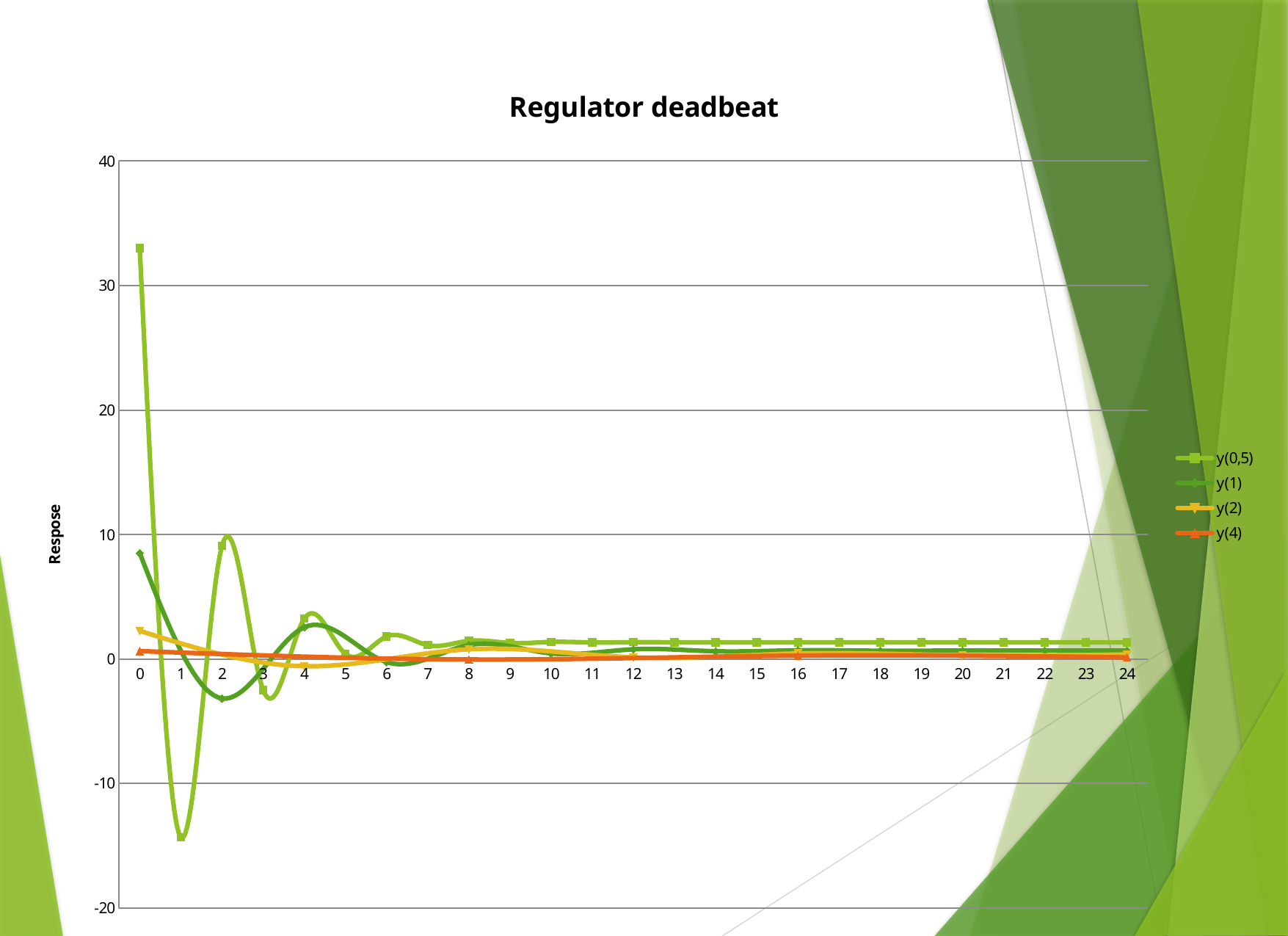
At x = 0, which is larger, the value of y(1) or the value of y(4)? y(1) What is the title of the chart? Regulator deadbeat How many series does the legend list? 4 What are the series names listed in the legend? y(0,5), y(1), y(2), y(4) Which series has the lowest value at x = 1? y(0,5) Is the value of y(0,5) at x = 0 greater or less than 30? greater Which series has the highest value at x = 0? y(0,5) Does the y(2) series rise or fall from x = 0 to x = 4? fall What kind of chart is shown on the slide? line chart Is the value of y(0,5) at x = 1 greater or less than -10? less Is the value of y(1) at x = 0 greater or less than 10? less